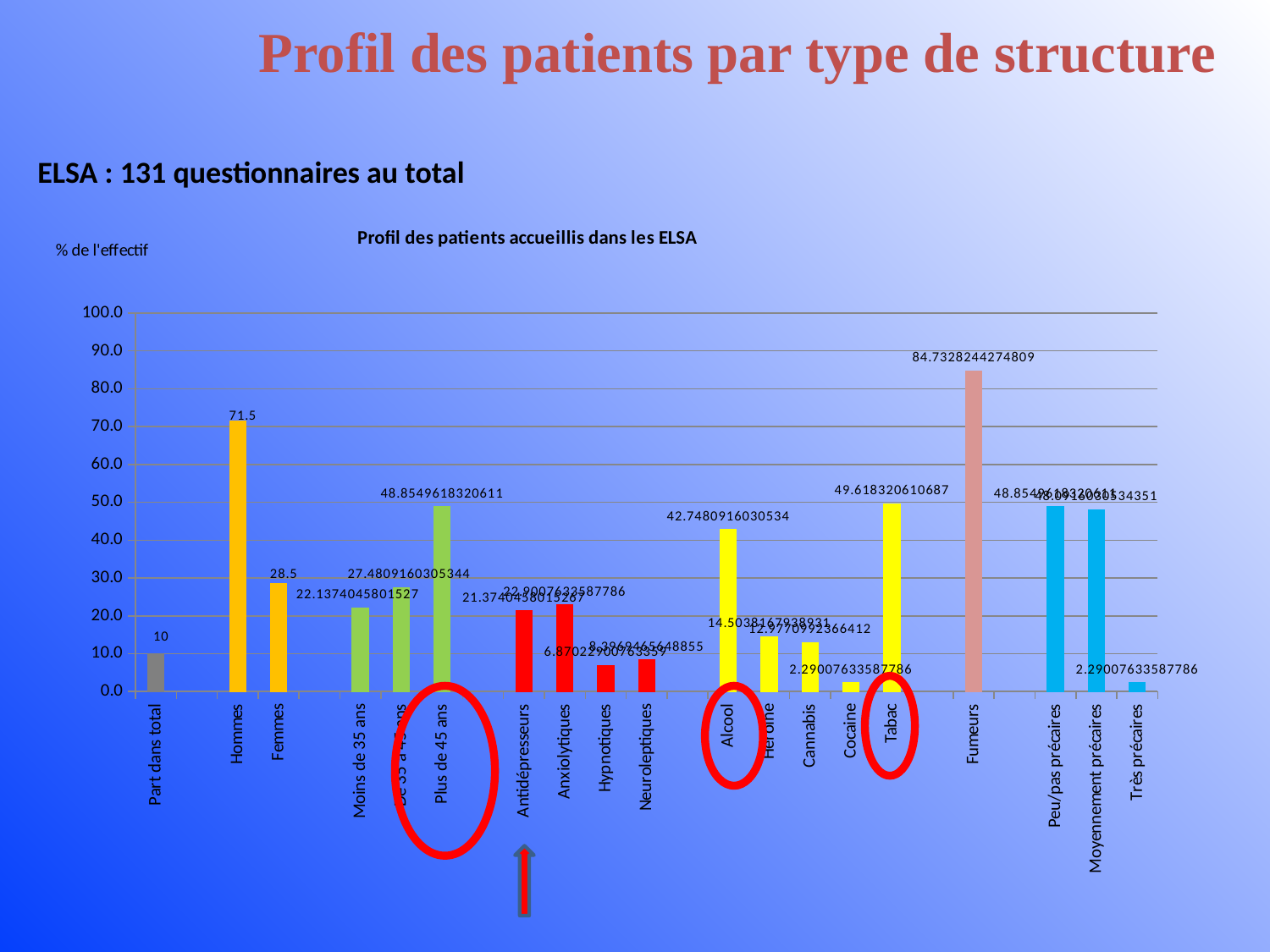
Which is larger, the value for Alcool or the value for Tabac? Tabac Which category has the highest value? Fumeurs What is the value for Femmes? 28.5 How many categories are shown on the x axis? 19 What kind of chart is this? bar chart Is the value for Hypnotiques greater or less than 10? less What is the title of the chart? Profil des patients accueillis dans les ELSA What is the value for Tabac? 49.618320610687 What is the difference between the values for Hommes and Femmes? 43 What is the value for Hommes? 71.5 What is the value for Part dans total? 10 What is the value for Fumeurs? 84.7328244274809